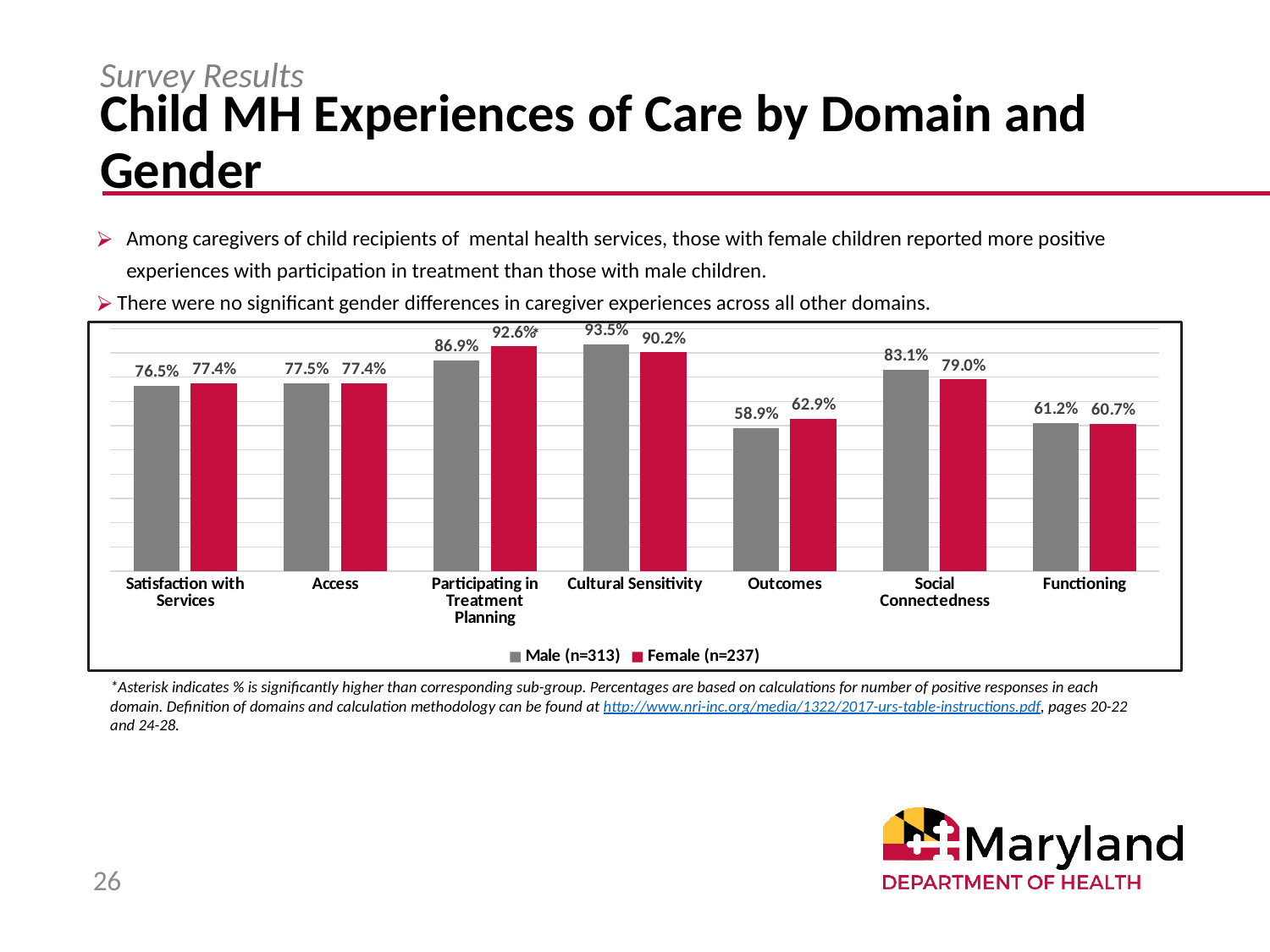
Which domain has the highest Male (n=313) value? Cultural Sensitivity How many series does the legend list? 2 What is the Female (n=237) value for Social Connectedness? 79.0% What is the difference between the Male (n=313) and Female (n=237) values for Social Connectedness? 4.1% What is the Male (n=313) value for Outcomes? 58.9% What kind of chart is shown on the slide? Bar chart What is the Male (n=313) value for Cultural Sensitivity? 93.5% Which domain has the lowest Female (n=237) value? Functioning How many domains are shown on the x axis of the chart? 7 For Outcomes, which is larger: the Male (n=313) value or the Female (n=237) value? Female (n=237) What is the Female (n=237) value for Participating in Treatment Planning? 92.6% What is the difference between the Female (n=237) and Male (n=313) values for Participating in Treatment Planning? 5.7%